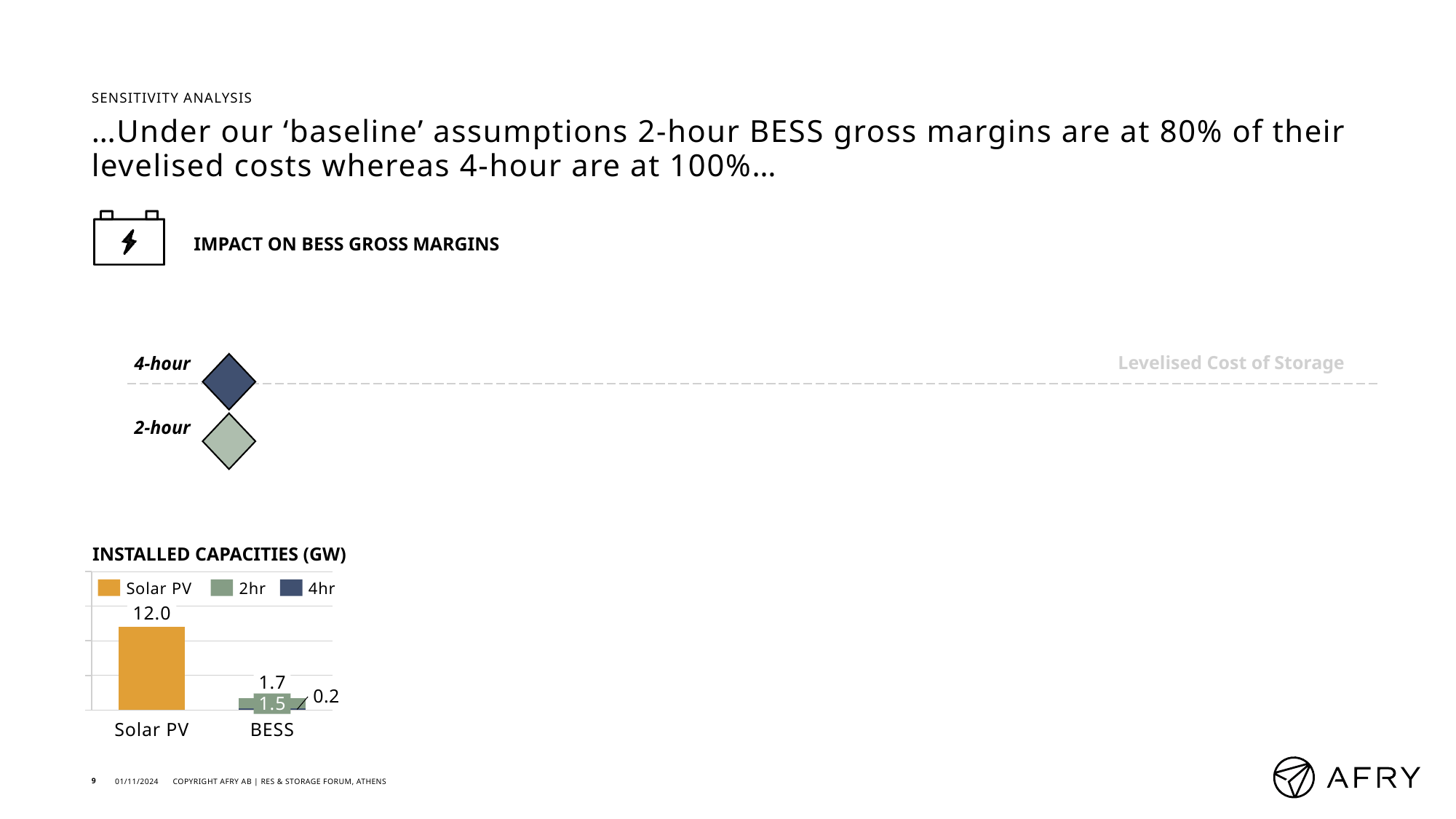
In the Installed Capacities (GW) chart, how many series does the legend list? 3 What kind of chart is the Installed Capacities (GW) chart? Bar chart In the Installed Capacities (GW) chart, which category has the lowest total installed capacity? BESS In the Installed Capacities (GW) chart, what is the 4hr capacity within the BESS bar? 0.2 In the Installed Capacities (GW) chart, which is larger within the BESS bar, the 2hr or the 4hr capacity? 2hr In the Installed Capacities (GW) chart, which category has the highest installed capacity? Solar PV In the Installed Capacities (GW) chart, what is the 2hr capacity within the BESS bar? 1.5 In the Installed Capacities (GW) chart, what is the total installed capacity of the BESS bar? 1.7 In the Installed Capacities (GW) chart, what is the installed capacity of Solar PV? 12.0 In the Installed Capacities (GW) chart, what colour represents Solar PV in the legend? Orange In the Installed Capacities (GW) chart, how many categories are shown on the x axis? 2 In the Installed Capacities (GW) chart, what is the difference between the Solar PV capacity and the total BESS capacity? 10.3